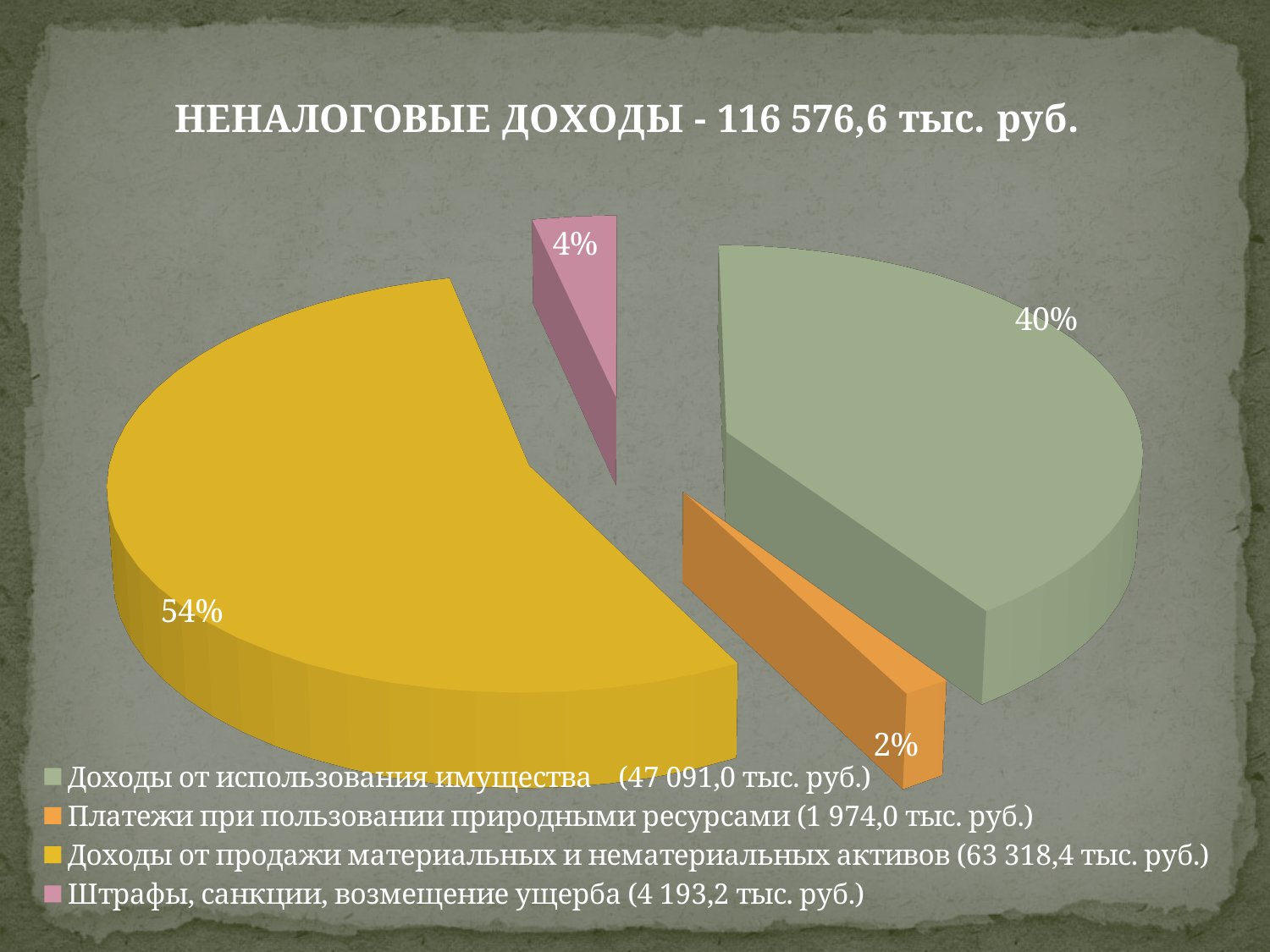
What share of the pie is 'Платежи при пользовании природными ресурсами'? 2% What kind of chart is shown on the slide? Pie chart What amount in тыс. руб. does the legend give for 'Доходы от использования имущества'? 47 091,0 тыс. руб. What share of the pie is 'Штрафы, санкции, возмещение ущерба'? 4% How many slices does the pie chart have? 4 What is the difference in percentage points between the 54% slice and the 40% slice? 14 percentage points Which category has the largest share of the pie? Доходы от продажи материальных и нематериальных активов Which category has the smallest share of the pie? Платежи при пользовании природными ресурсами What share of the pie is 'Доходы от использования имущества'? 40% What is the title of the chart? НЕНАЛОГОВЫЕ ДОХОДЫ - 116 576,6 тыс. руб. Which is larger: the share for 'Штрафы, санкции, возмещение ущерба' or the share for 'Платежи при пользовании природными ресурсами'? Штрафы, санкции, возмещение ущерба